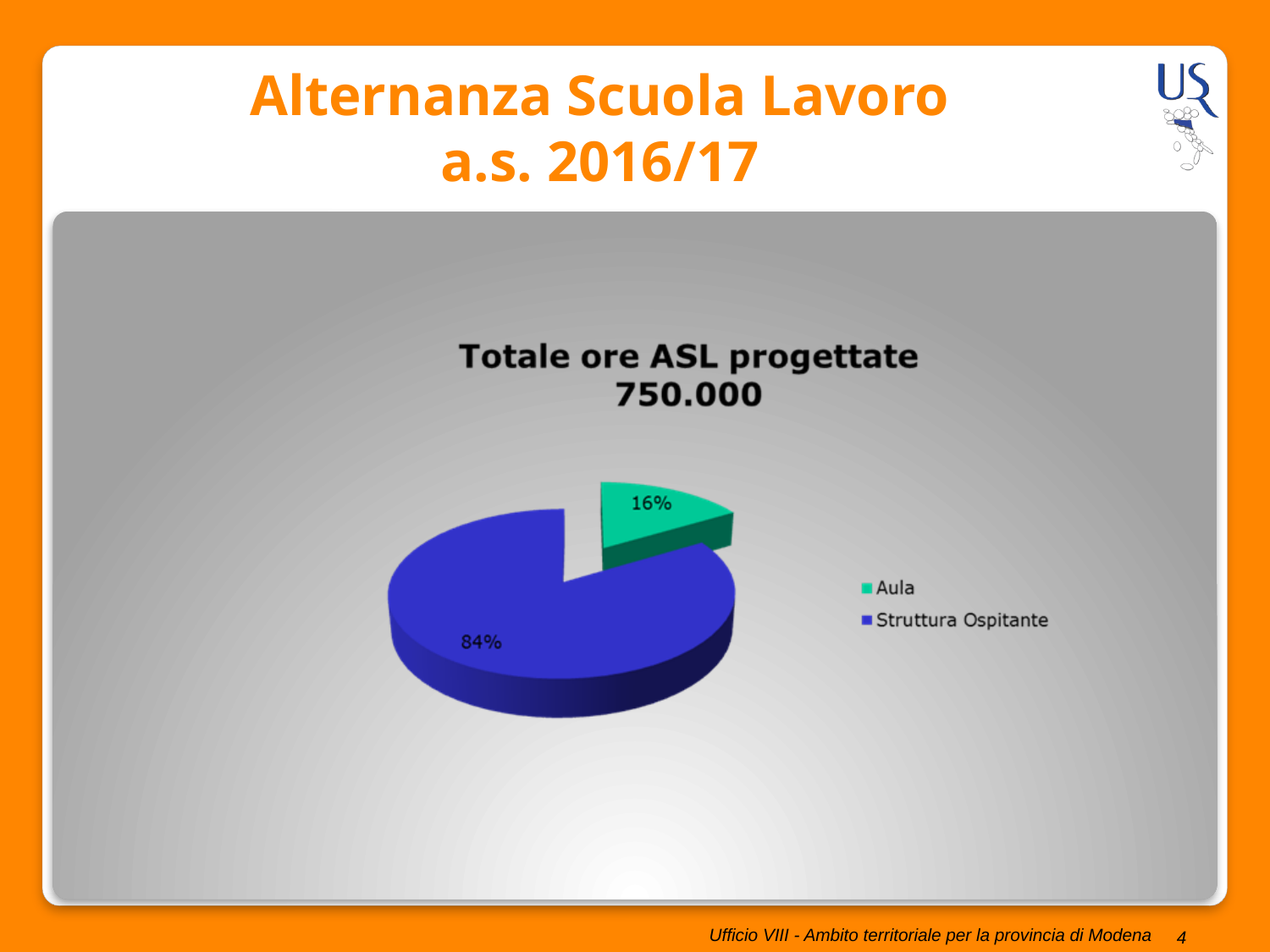
What is the title of the chart? Totale ore ASL progettate 750.000 Which category has the smallest slice of the pie? Aula How many slices does the pie chart have? 2 Which slice is larger, Aula or Struttura Ospitante? Struttura Ospitante How many entries does the legend list? 2 What colour is the Aula slice in the pie chart? Green What kind of chart is shown on the slide? Pie chart Is the share for Aula greater or less than 50%? less What is the difference in percentage points between the Struttura Ospitante and Aula slices? 68 Which category has the largest slice of the pie? Struttura Ospitante What share of the pie does the Struttura Ospitante slice represent? 84% What share of the pie does the Aula slice represent? 16%